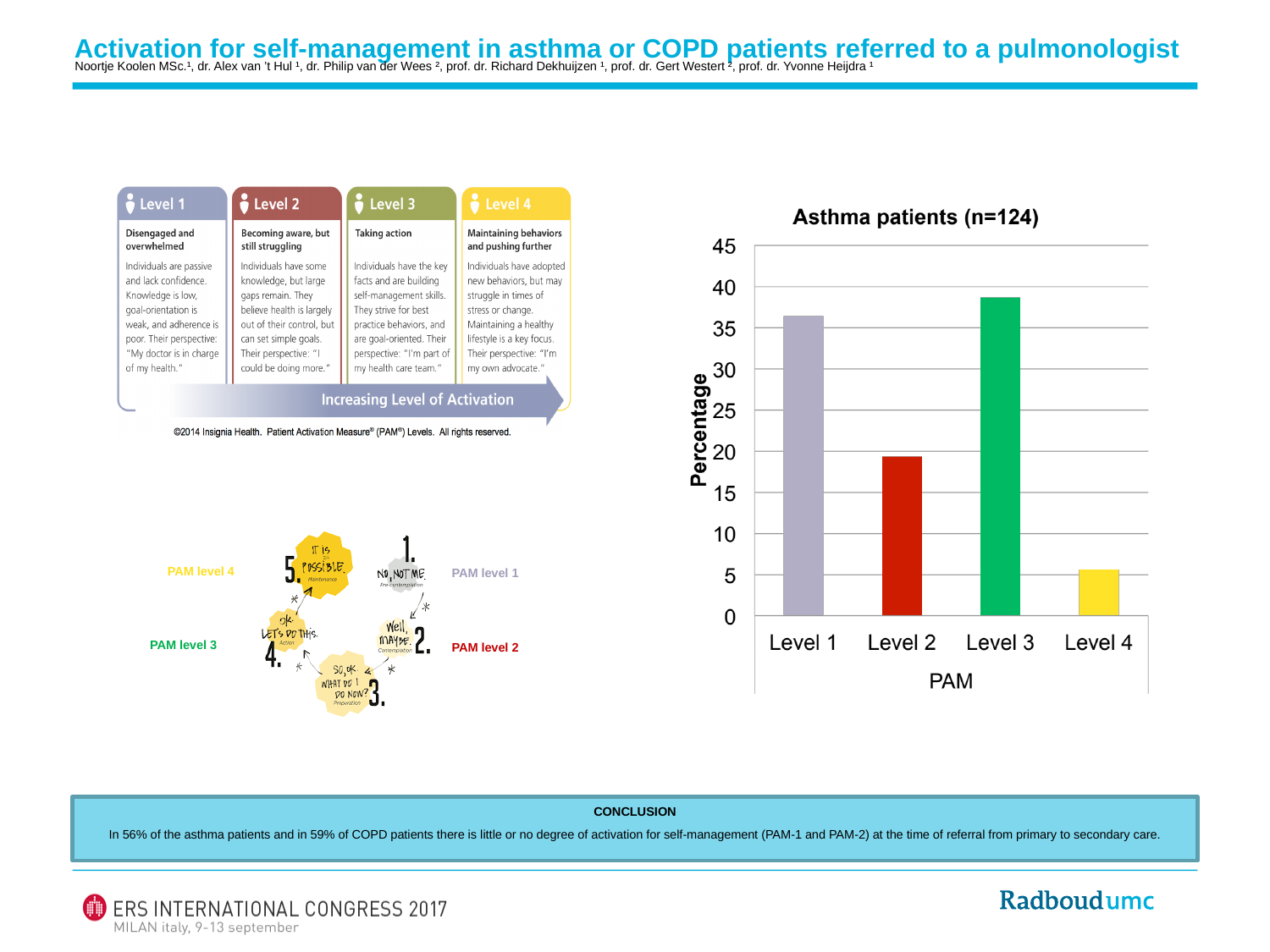
What is the label of the y axis of the chart? Percentage What kind of chart is shown on the slide? bar chart Is the percentage for Level 2 greater or less than 15? greater Which PAM level has the highest percentage in the chart? Level 3 Is the percentage for Level 1 greater or less than 30? greater Is the percentage for Level 4 greater or less than 10? less What is the title of the chart? Asthma patients (n=124) Which has a higher percentage, Level 2 or Level 4? Level 2 How many PAM levels are plotted on the x axis of the chart? 4 Which PAM level has the lowest percentage in the chart? Level 4 Which has a higher percentage, Level 1 or Level 2? Level 1